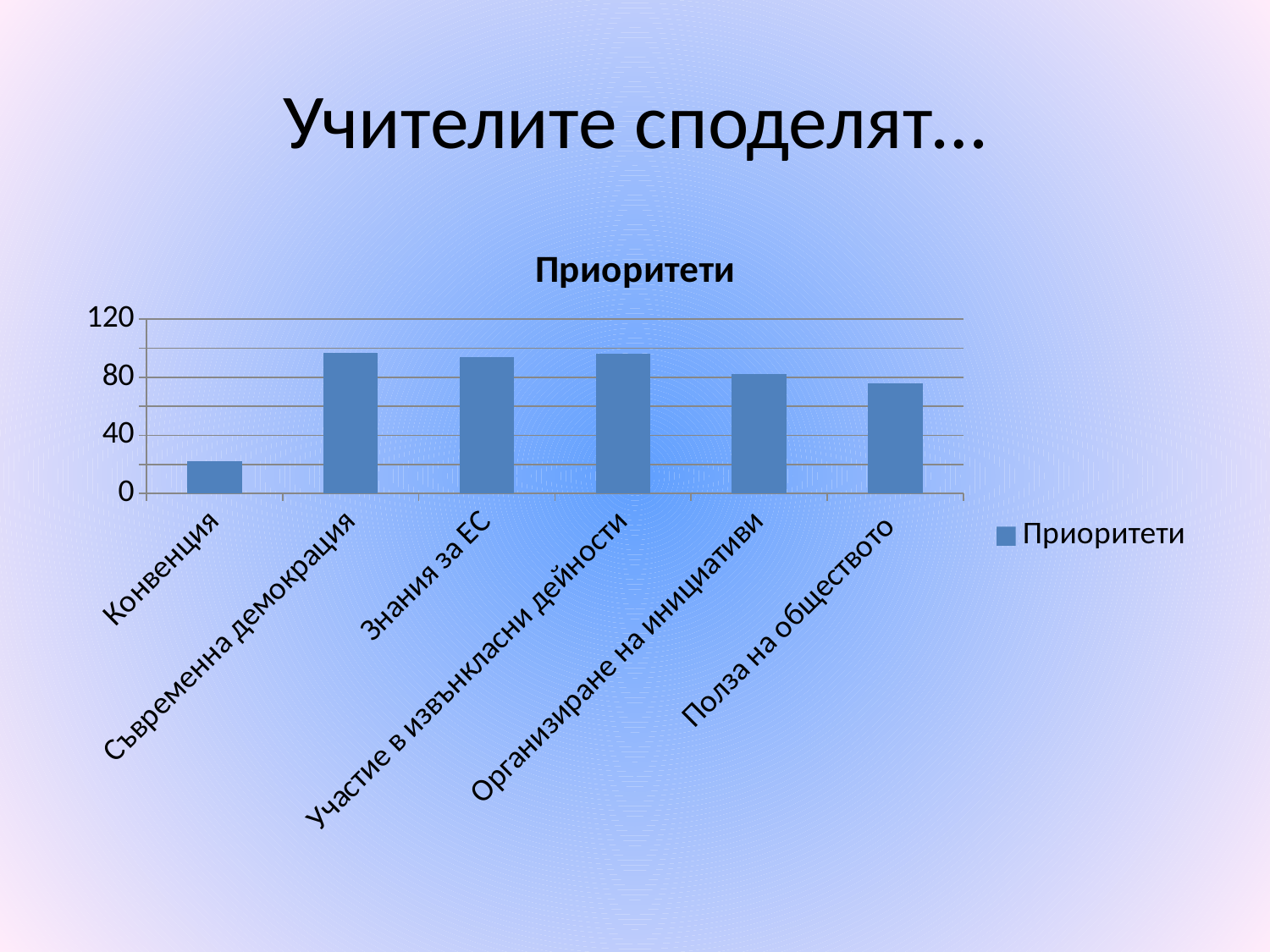
Is the value for Конвенция greater or less than 40? less How many categories are shown on the x axis of the chart? 6 What kind of chart is shown on the slide? bar chart What is the title of the chart? Приоритети Which is larger, the value for Конвенция or the value for Полза на обществото? Полза на обществото What is the name of the series listed in the legend? Приоритети Is the value for Полза на обществото greater or less than 80? less Is the value for Съвременна демокрация greater or less than 80? greater Which category has the lowest value? Конвенция Which is larger, the value for Съвременна демокрация or the value for Полза на обществото? Съвременна демокрация How many series does the legend list? 1